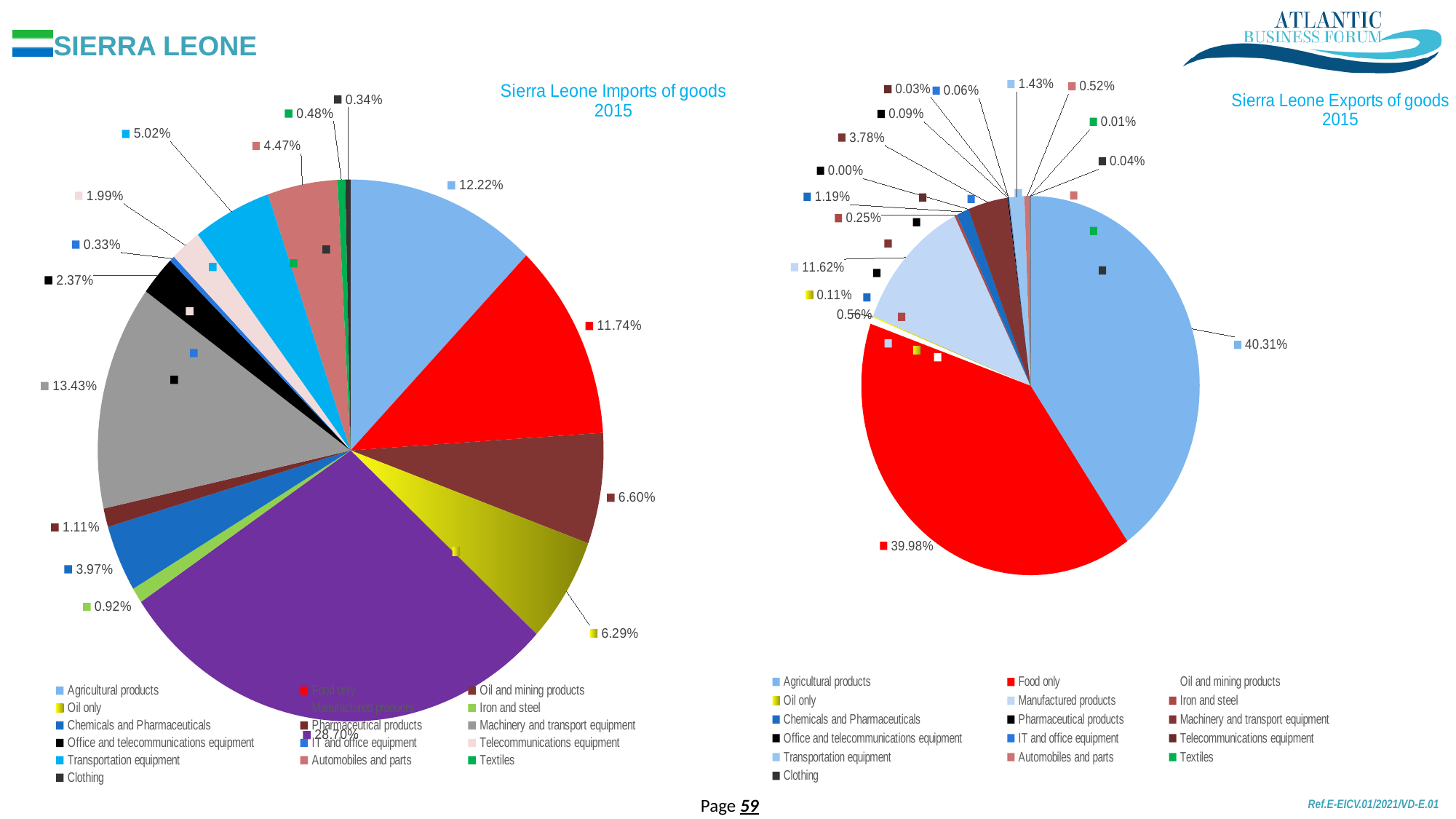
On the Sierra Leone Exports of goods 2015 chart, what share do Manufactured products have? 11.62% On the Sierra Leone Imports of goods 2015 chart, what share do Machinery and transport equipment have? 13.43% On the Sierra Leone Imports of goods 2015 chart, what is the difference between the shares of Agricultural products and Food only? 0.48% On the Sierra Leone Exports of goods 2015 chart, what share does Food only have? 39.98% On the Sierra Leone Exports of goods 2015 chart, what is the difference between the shares of Agricultural products and Food only? 0.33% On the Sierra Leone Exports of goods 2015 chart, what share do Agricultural products have? 40.31% On the Sierra Leone Imports of goods 2015 chart, what share do Manufactured products have? 28.70% On the Sierra Leone Imports of goods 2015 chart, which is larger: Oil and mining products or Oil only? Oil and mining products On the Sierra Leone Imports of goods 2015 chart, which category has the largest share? Manufactured products On the Sierra Leone Imports of goods 2015 chart, what share does Transportation equipment have? 5.02% What kind of chart is used for Sierra Leone Exports of goods 2015? Pie chart How many categories does the legend of the Sierra Leone Imports of goods 2015 chart list? 16